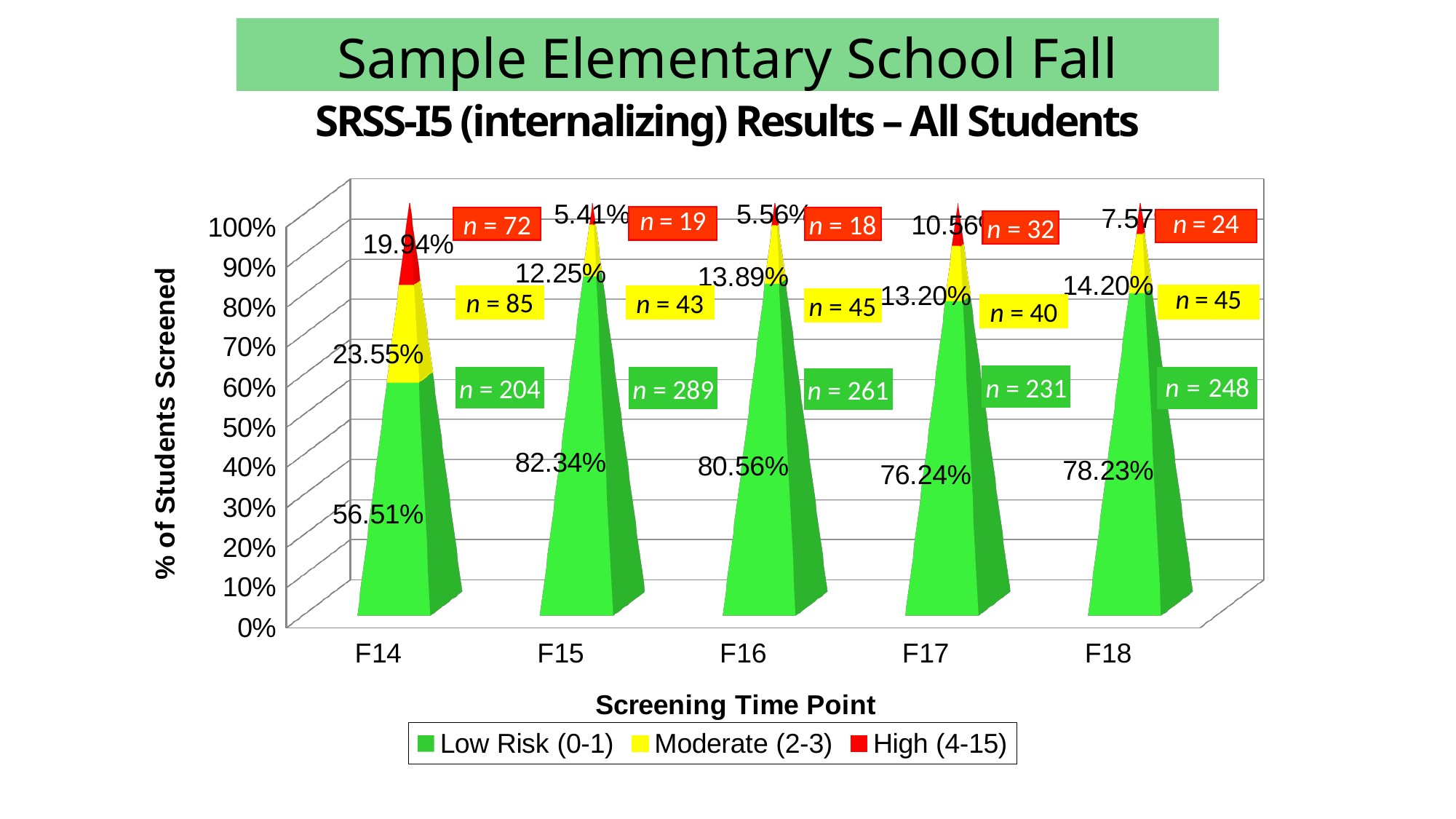
What percentage of students screened were High (4-15) at F15? 5.41% How many screening time points are shown on the x axis? 5 What is the n value shown for the Low Risk (0-1) group at F15? n = 289 What is the label of the y axis? % of Students Screened Is the Moderate (2-3) percentage larger at F14 or at F18? F14 What percentage of students screened were Low Risk (0-1) at F14? 56.51% What is the difference between the Low Risk (0-1) percentages at F15 and F14? 25.83% Which screening time point has the highest Low Risk (0-1) percentage? F15 Which screening time point has the lowest Low Risk (0-1) percentage? F14 What percentage of students screened were Moderate (2-3) at F16? 13.89% How many series does the legend list? 3 What is the n value shown for the High (4-15) group at F14? n = 72